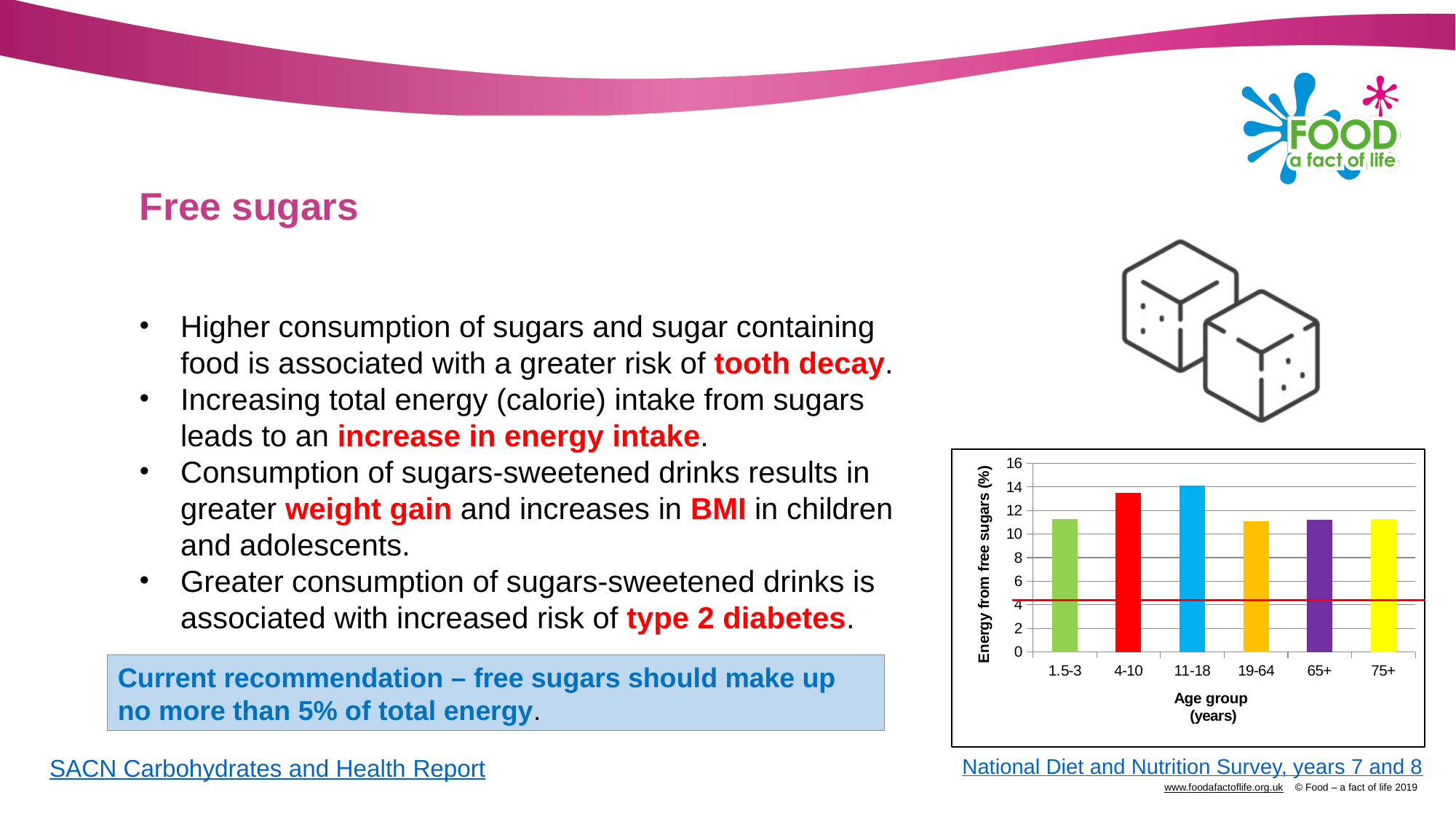
What is the label of the vertical axis of the chart? Energy from free sugars (%) Which age group has the highest energy from free sugars in the chart? 11-18 Is the value for the 4-10 age group greater or less than 12? greater Is the value for the 11-18 age group greater or less than 12? greater Which has a higher energy from free sugars value: the 11-18 age group or the 65+ age group? 11-18 Which has a higher energy from free sugars value: the 4-10 age group or the 19-64 age group? 4-10 What colour is the bar for the 11-18 age group? blue Is the value for the 19-64 age group greater or less than 10? greater How many age groups are shown on the x axis of the chart? 6 What kind of chart is shown on the slide? bar chart